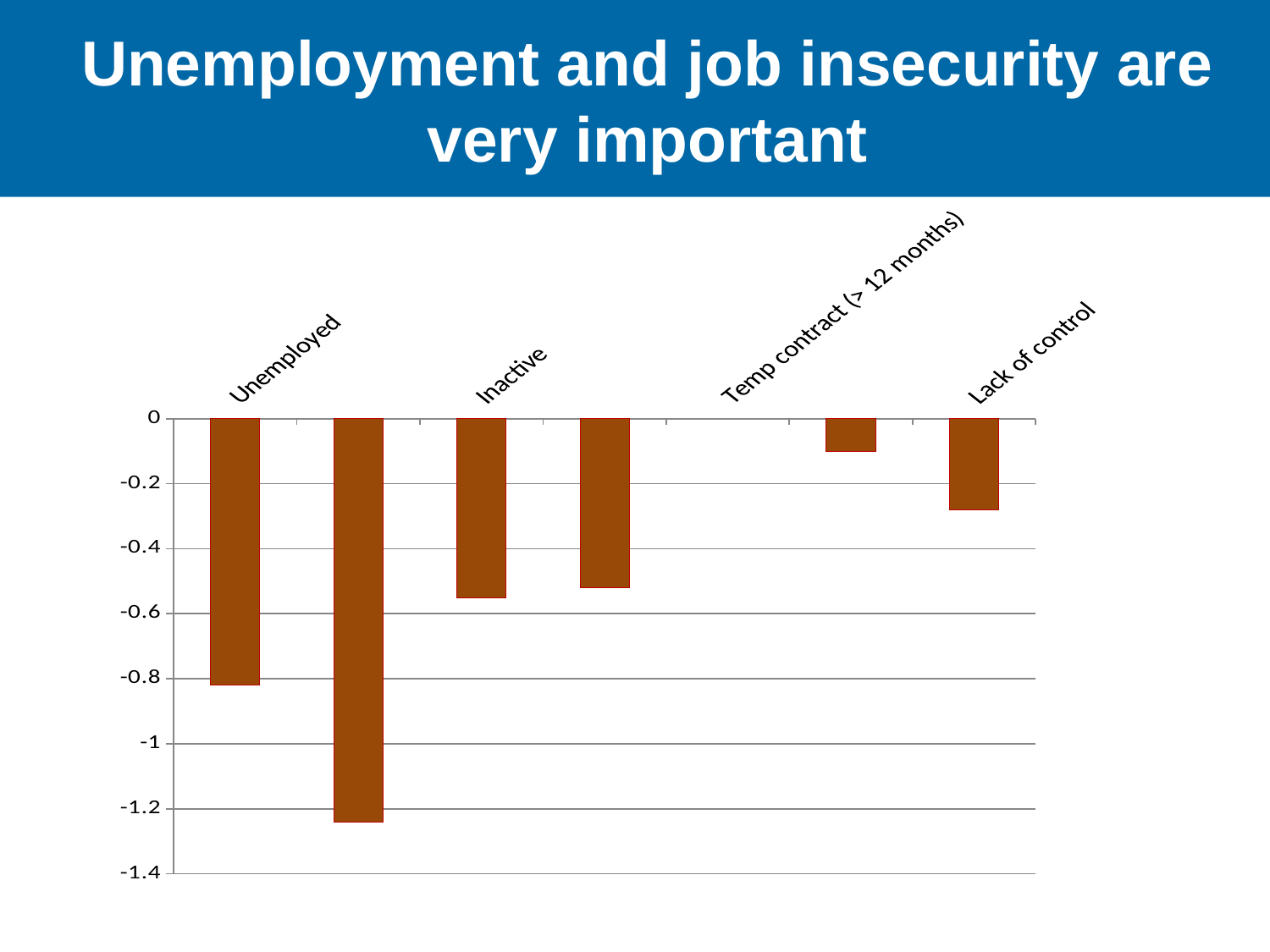
Which has the lower value, Inactive or Lack of control? Inactive Is the value for Lack of control greater or less than -0.2? less Is the value for Inactive greater or less than -0.6? greater Is the value for Lack of control greater or less than -0.4? greater What kind of chart is shown on the slide? bar chart What is the title of the slide containing the chart? Unemployment and job insecurity are very important How many bars are drawn in the chart? 6 What is the lowest value shown on the vertical axis? -1.4 How many category labels are printed along the x axis of the chart? 4 Which has the lower value, Unemployed or Inactive? Unemployed